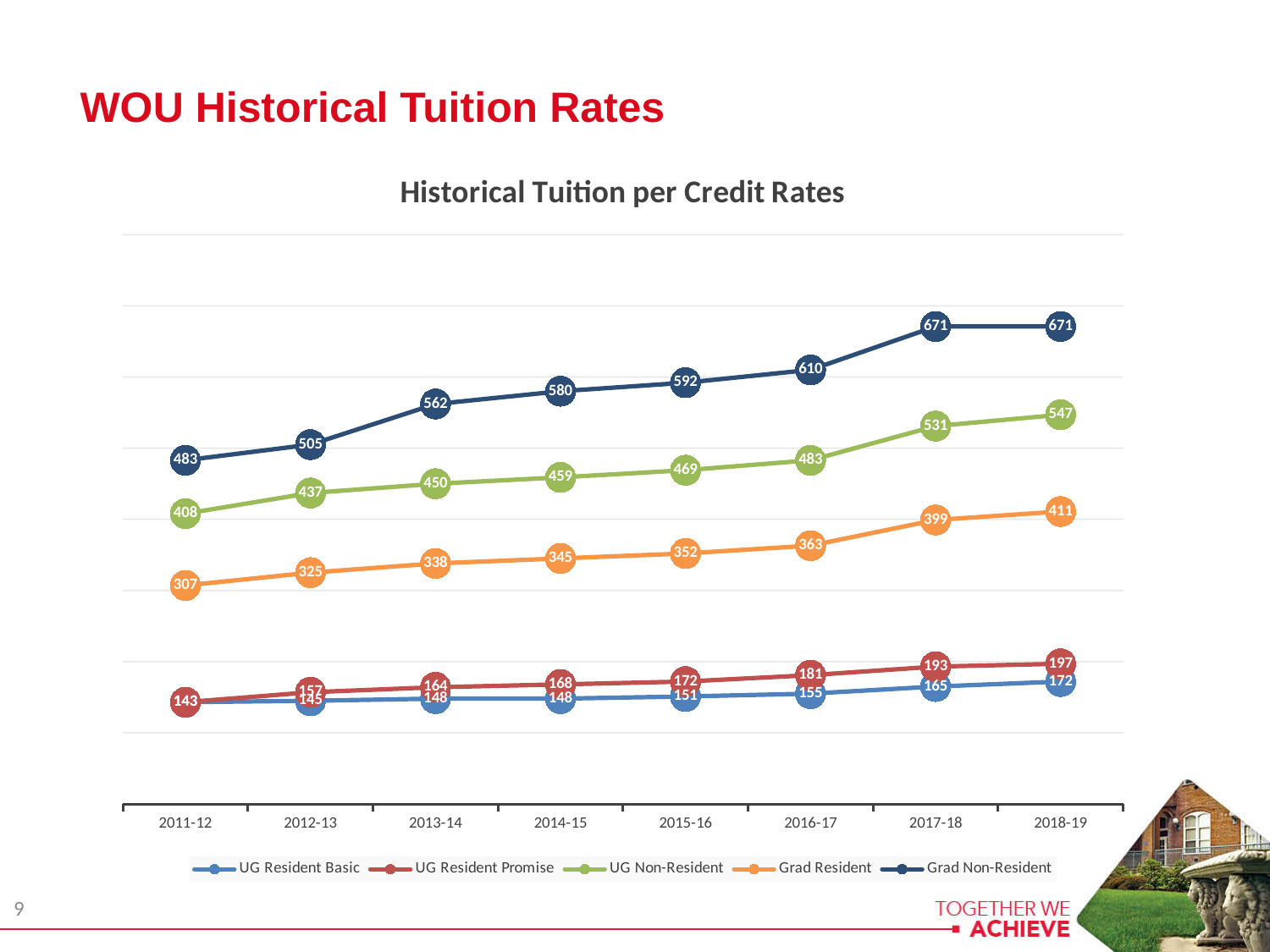
Which is larger in 2017-18: the UG Non-Resident rate or the Grad Resident rate? UG Non-Resident What is the Grad Non-Resident tuition per credit rate in 2017-18? 671 Which series has the highest tuition per credit rate in 2018-19? Grad Non-Resident Which series has the lowest tuition per credit rate in 2018-19? UG Resident Basic What is the difference between the Grad Non-Resident rate in 2018-19 and in 2011-12? 188 How many series does the legend list? 5 What kind of chart is shown on the slide? Line chart What is the Grad Resident tuition per credit rate in 2018-19? 411 What is the UG Resident Promise tuition per credit rate in 2016-17? 181 What is the UG Non-Resident tuition per credit rate in 2014-15? 459 How many academic years are shown on the x axis? 8 Does the Grad Resident tuition per credit rate rise or fall from 2011-12 to 2018-19? Rise